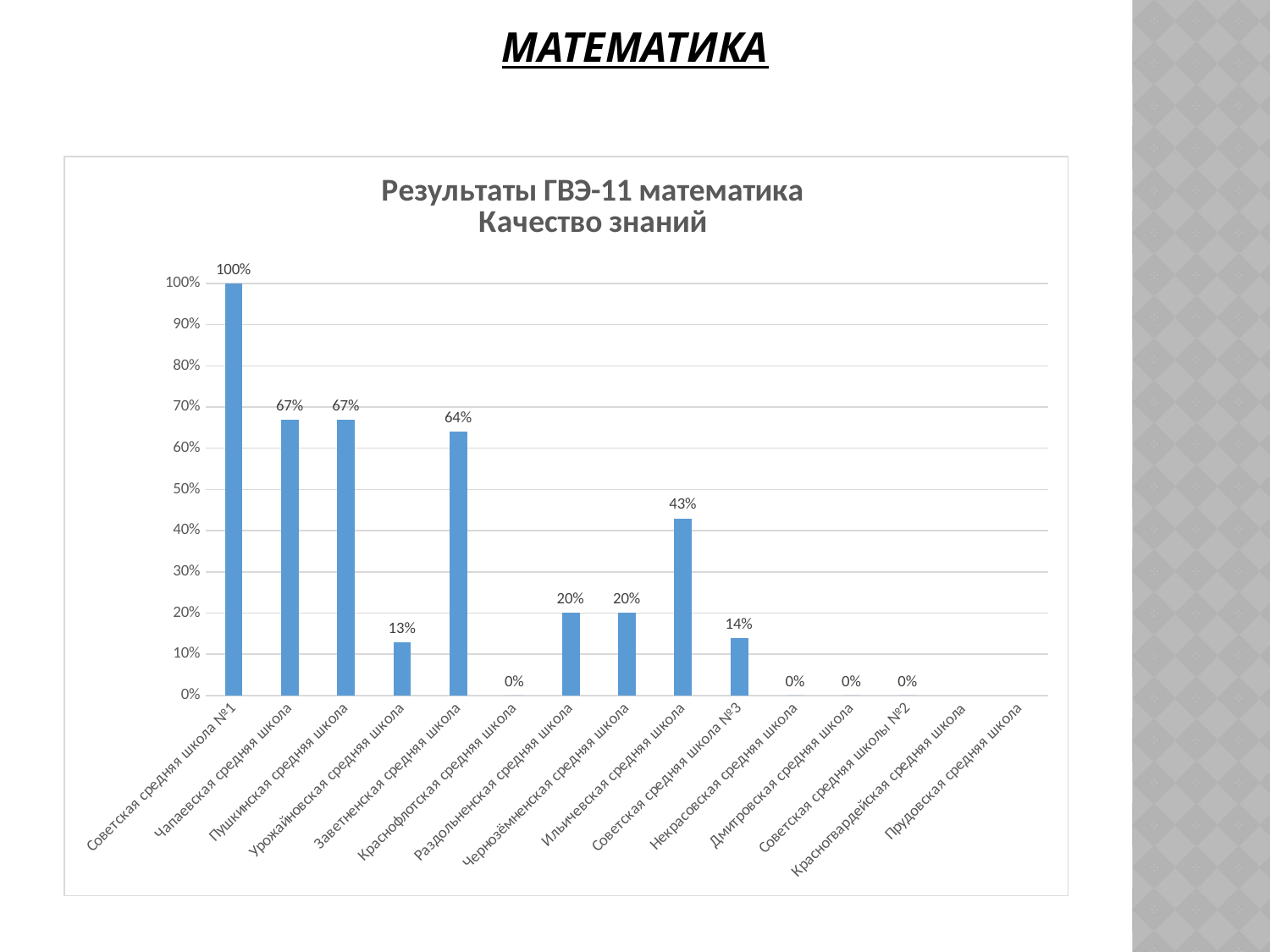
What is the value for Советская средняя школа №1? 100% What is the value for Ильичевская средняя школа? 43% Is the value for Урожайновская средняя школа greater or less than 20%? less What is the value for Заветненская средняя школа? 64% Which school has the highest value? Советская средняя школа №1 What is the difference between the values for Советская средняя школа №1 and Заветненская средняя школа? 36% What kind of chart is shown on the slide? bar chart What is the difference between the values for Ильичевская средняя школа and Советская средняя школа №3? 29% How many schools have a data label of 0%? 4 What is the title of the chart? Результаты ГВЭ-11 математика Качество знаний Which is larger, the value for Заветненская средняя школа or Ильичевская средняя школа? Заветненская средняя школа What is the value for Советская средняя школа №3? 14%